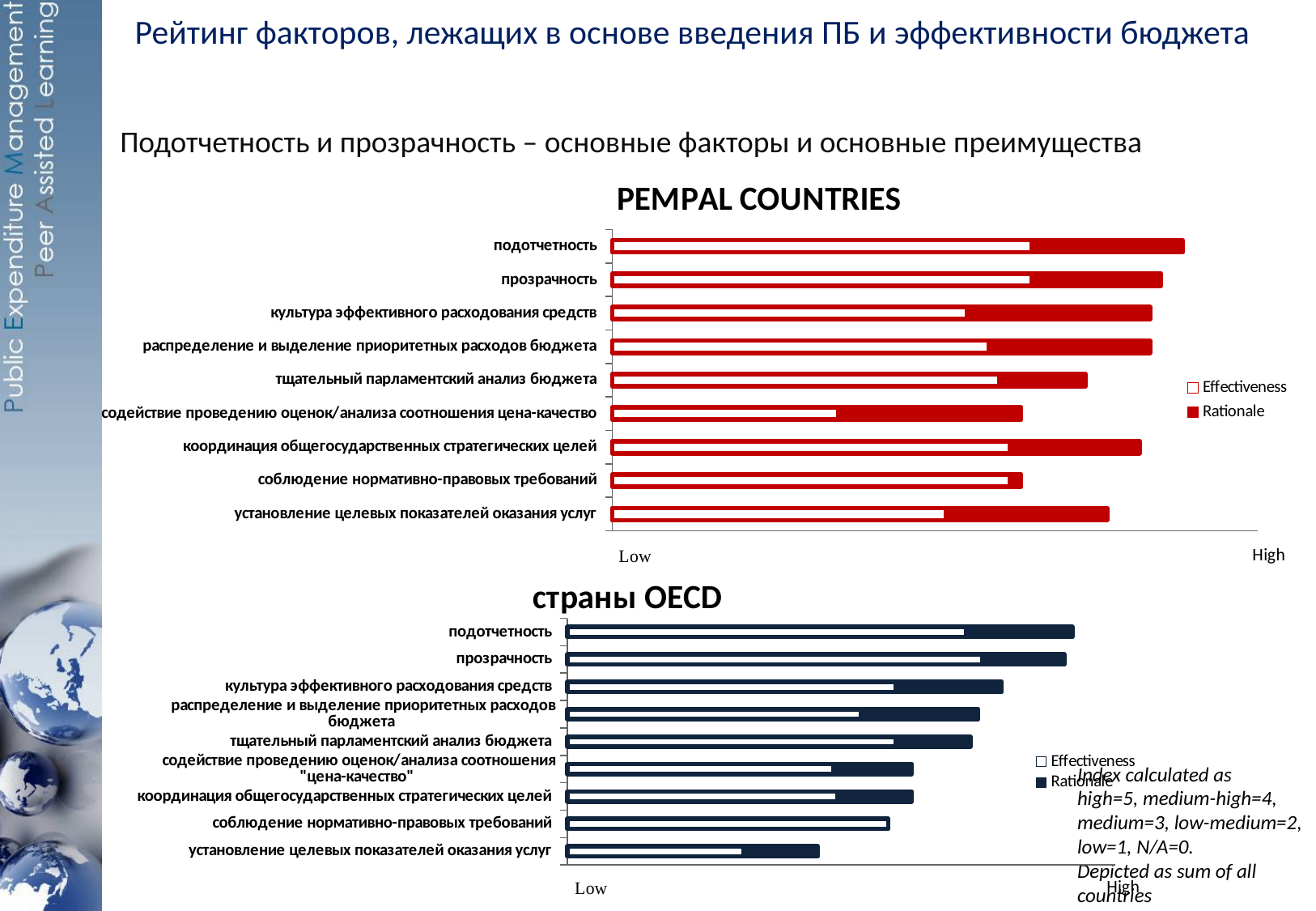
In the PEMPAL COUNTRIES chart, which has the larger Rationale value: подотчетность or установление целевых показателей оказания услуг? установление целевых показателей оказания услуг How many categories are shown in the PEMPAL COUNTRIES chart? 9 What are the two legend entries in the страны OECD chart? Effectiveness and Rationale What colour are the Rationale bars in the PEMPAL COUNTRIES chart? red How many series does the legend of the PEMPAL COUNTRIES chart list? 2 In the PEMPAL COUNTRIES chart, which category has the shortest Effectiveness bar? содействие проведению оценок/анализа соотношения цена-качество In the PEMPAL COUNTRIES chart, which has the larger Effectiveness value: культура эффективного расходования средств or содействие проведению оценок/анализа соотношения цена-качество? культура эффективного расходования средств What kind of chart is the PEMPAL COUNTRIES chart? bar chart In the страны OECD chart, which has the larger Effectiveness value: соблюдение нормативно-правовых требований or установление целевых показателей оказания услуг? соблюдение нормативно-правовых требований How many categories are shown in the страны OECD chart? 9 In the страны OECD chart, which category has the shortest Rationale bar? соблюдение нормативно-правовых требований